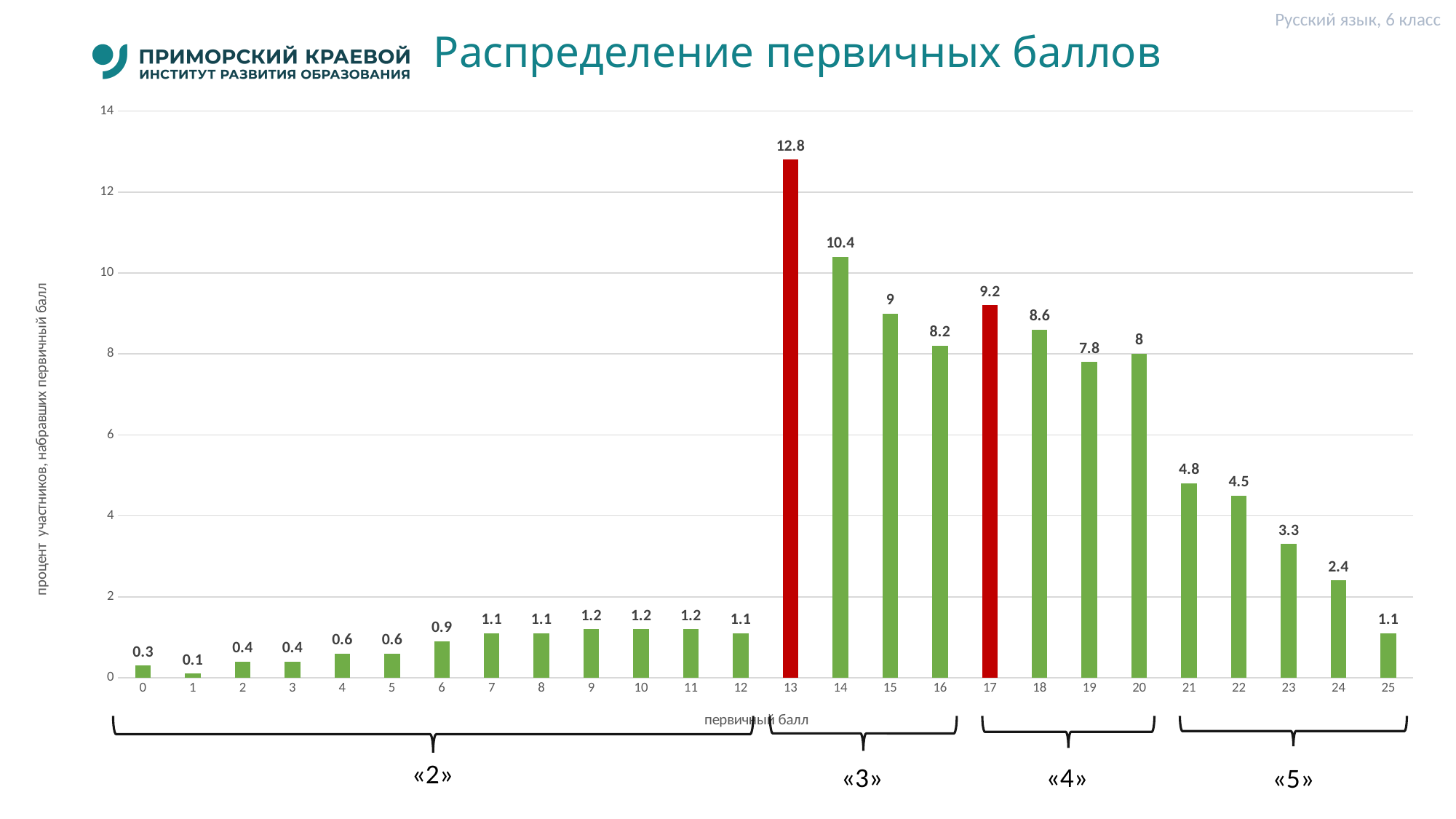
What kind of chart is shown on the slide? bar chart What is the value for primary score 13? 12.8 Which two primary scores are shown with red bars? 13 and 17 Which is larger, the value for primary score 17 or for primary score 18? 17 Is the value for primary score 21 greater or less than 4? greater Which primary score has the highest percentage of participants? 13 What is the value for primary score 20? 8 How many primary score categories are shown on the x axis? 26 What is the difference between the values for primary scores 13 and 14? 2.4 Do the values rise or fall from primary score 21 to primary score 25? fall Which primary score has the lowest percentage of participants? 1 What is the value for primary score 25? 1.1